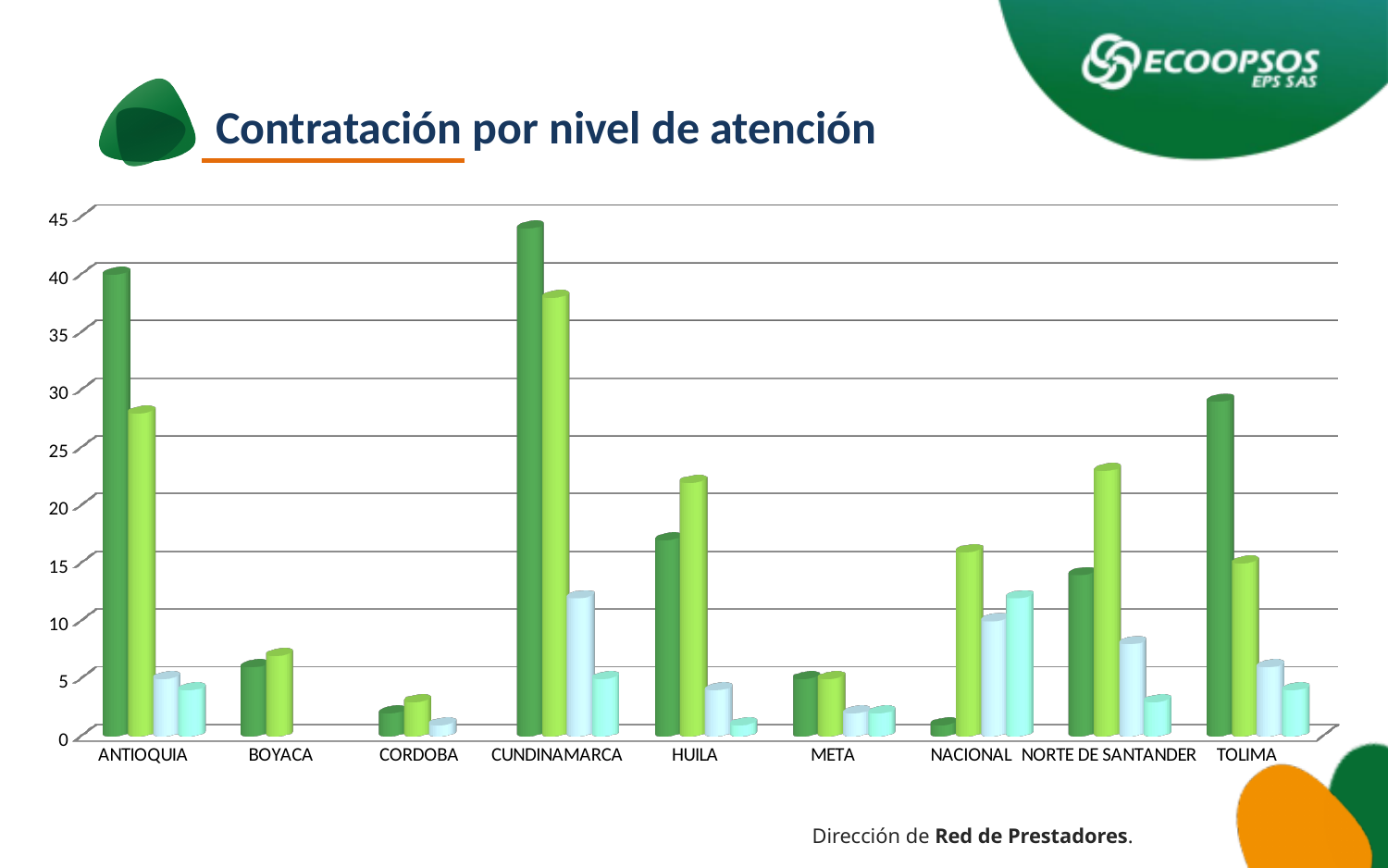
Is the dark green bar for CUNDINAMARCA greater or less than 40? greater What is the title of the chart on the slide? Contratación por nivel de atención What kind of chart is shown on the slide? bar chart Which category has the shortest light green bar? CORDOBA Which category has the tallest light green bar? CUNDINAMARCA Which is larger, the dark green bar for ANTIOQUIA or the dark green bar for TOLIMA? ANTIOQUIA Is the dark green bar for TOLIMA greater or less than 25? greater Is the light green bar for CUNDINAMARCA greater or less than 35? greater Which category has the tallest dark green bar? CUNDINAMARCA How many categories (departments) are shown on the x axis of the chart? 9 Which is larger, the light green bar for HUILA or the light green bar for BOYACA? HUILA